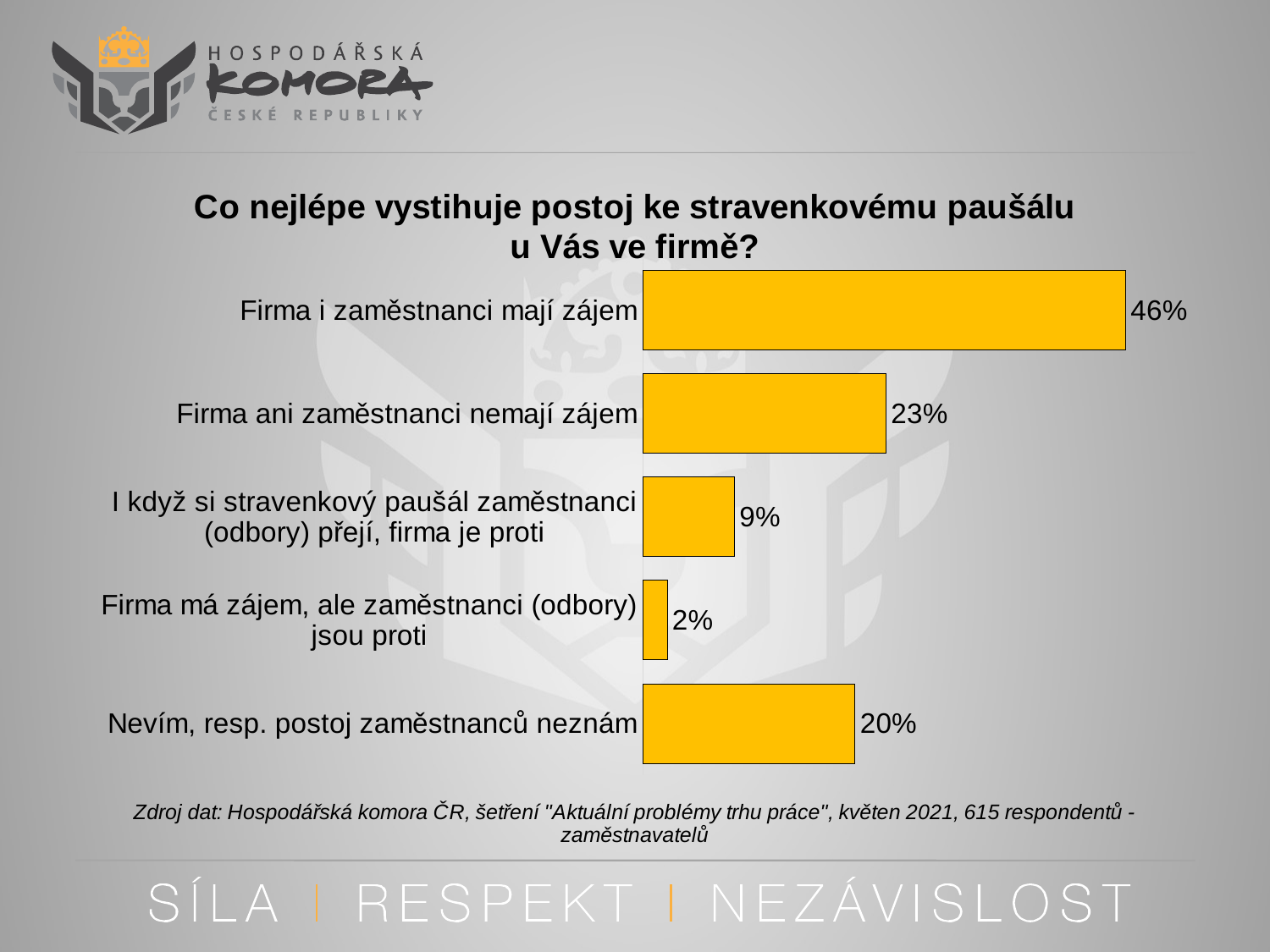
What percentage is shown for "Nevím, resp. postoj zaměstnanců neznám"? 20% What percentage is shown for "Firma i zaměstnanci mají zájem"? 46% What is the difference between the values for "Firma i zaměstnanci mají zájem" and "Firma ani zaměstnanci nemají zájem"? 23% What value is shown for "Firma má zájem, ale zaměstnanci (odbory) jsou proti"? 2% Which category has the highest value? Firma i zaměstnanci mají zájem Which category has the lowest value? Firma má zájem, ale zaměstnanci (odbory) jsou proti What is the title of the chart? Co nejlépe vystihuje postoj ke stravenkovému paušálu u Vás ve firmě? What value is shown for "Firma ani zaměstnanci nemají zájem"? 23% What is the difference between the values for "I když si stravenkový paušál zaměstnanci (odbory) přejí, firma je proti" and "Firma má zájem, ale zaměstnanci (odbory) jsou proti"? 7% How many categories does the chart show? 5 Which is larger: the value for "Firma ani zaměstnanci nemají zájem" or for "Nevím, resp. postoj zaměstnanců neznám"? Firma ani zaměstnanci nemají zájem What kind of chart is shown on the slide? Bar chart